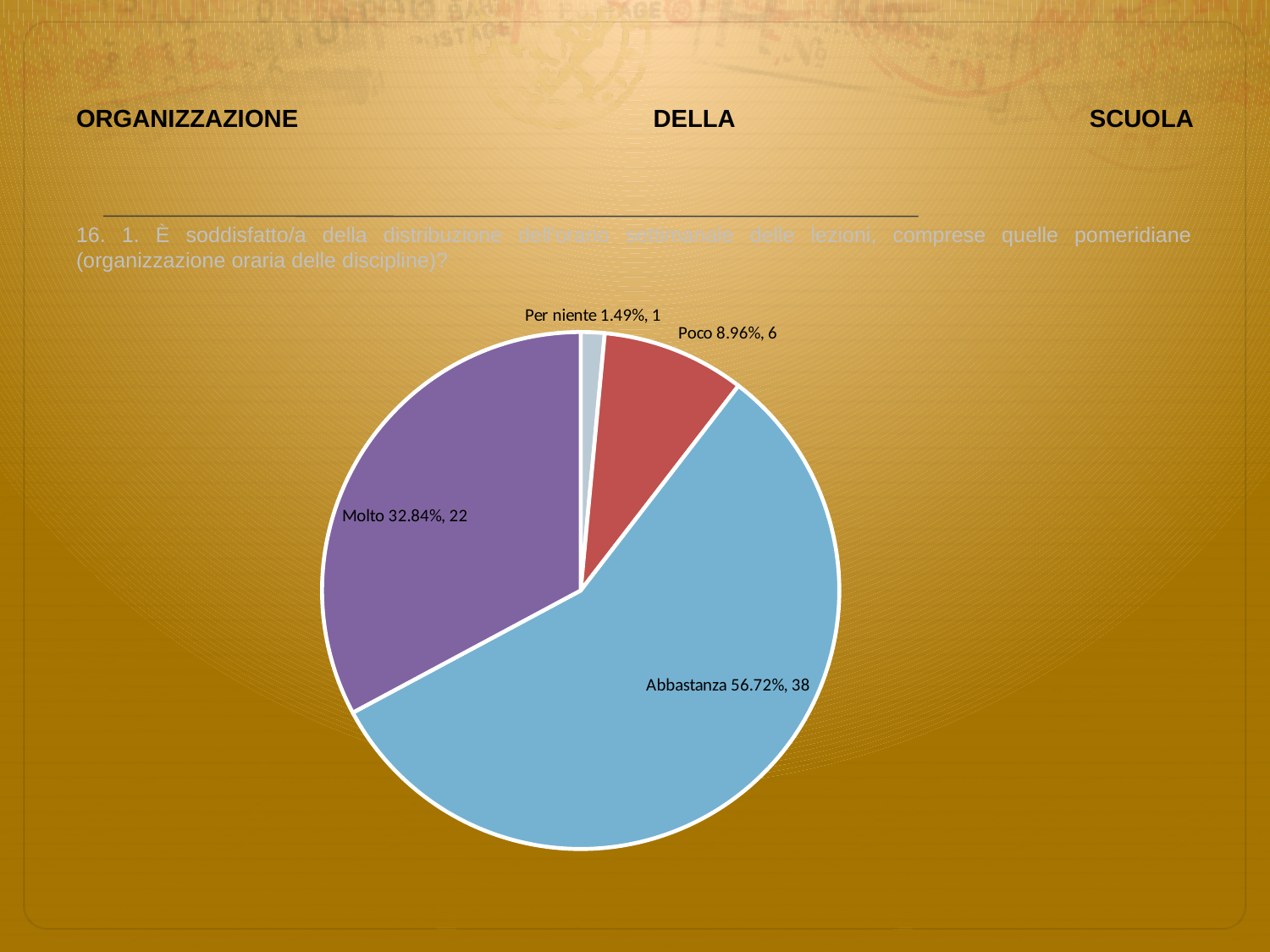
What is the difference in count between 'Abbastanza' and 'Molto'? 16 What count is shown for the 'Per niente' slice? 1 Which category has the largest slice? Abbastanza Which category has the smallest slice? Per niente What count is shown for the 'Molto' slice? 22 What is the total count across all slices? 67 How many slices does the pie chart have? 4 What kind of chart is shown on the slide? pie chart Which is larger, the 'Poco' slice or the 'Molto' slice? Molto What colour is the 'Abbastanza' slice? light blue What percentage is shown for the 'Abbastanza' slice? 56.72% What percentage is shown for the 'Poco' slice? 8.96%